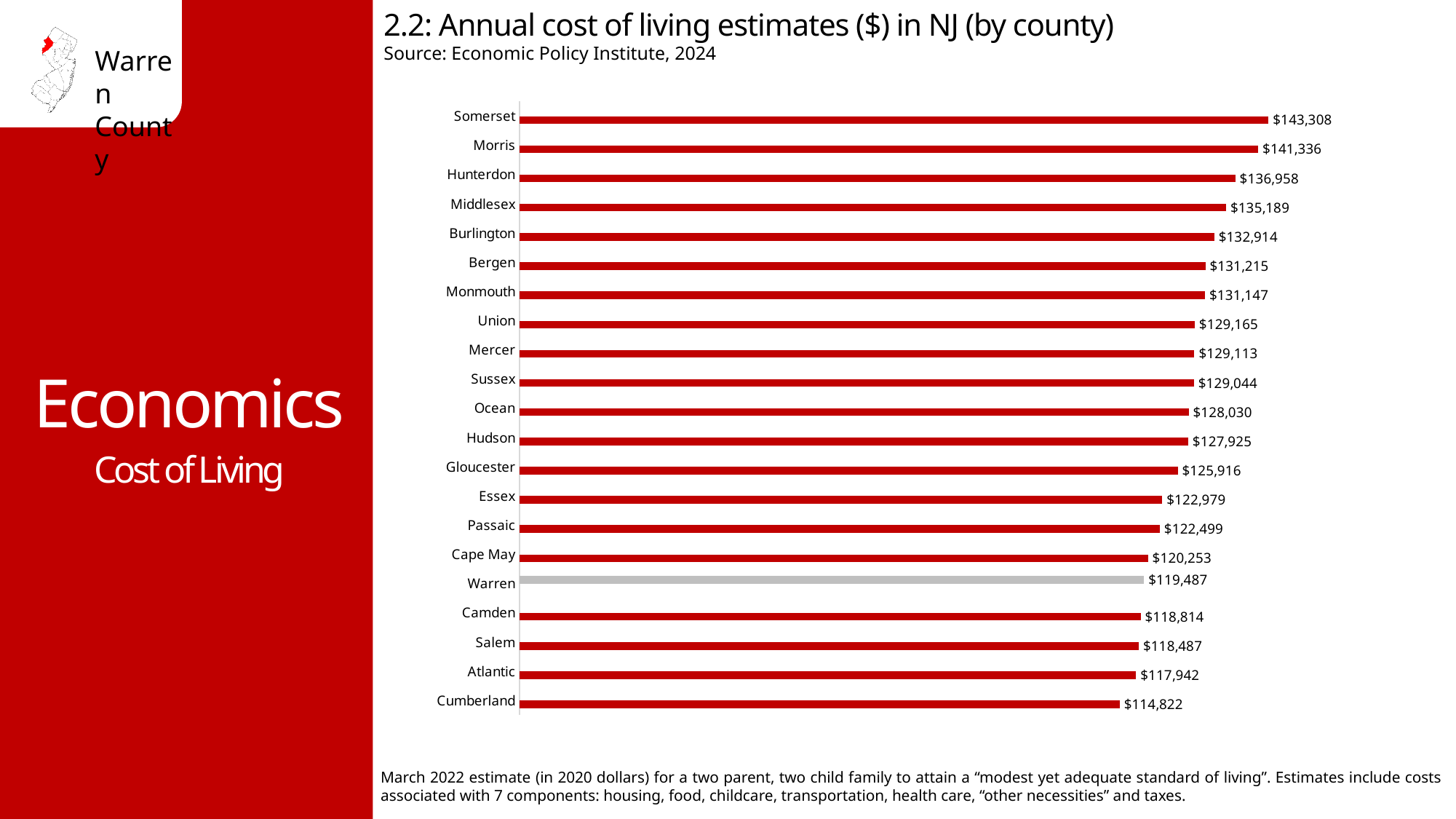
How much higher is Warren County's cost of living estimate than Cumberland County's? $4,665 Which county has the highest annual cost of living estimate? Somerset Which county has a higher cost of living estimate, Morris or Middlesex? Morris Which county has the lowest annual cost of living estimate? Cumberland What is the difference between the cost of living estimates for Somerset and Cumberland counties? $28,486 What type of chart is used to show the cost of living estimates? Bar chart Which county has a higher cost of living estimate, Essex or Gloucester? Gloucester Which county's bar is shown in gray rather than red? Warren What is the annual cost of living estimate for Hunterdon County? $136,958 How many counties are shown in the chart? 21 What is the annual cost of living estimate for Warren County? $119,487 What is the annual cost of living estimate for Cape May County? $120,253